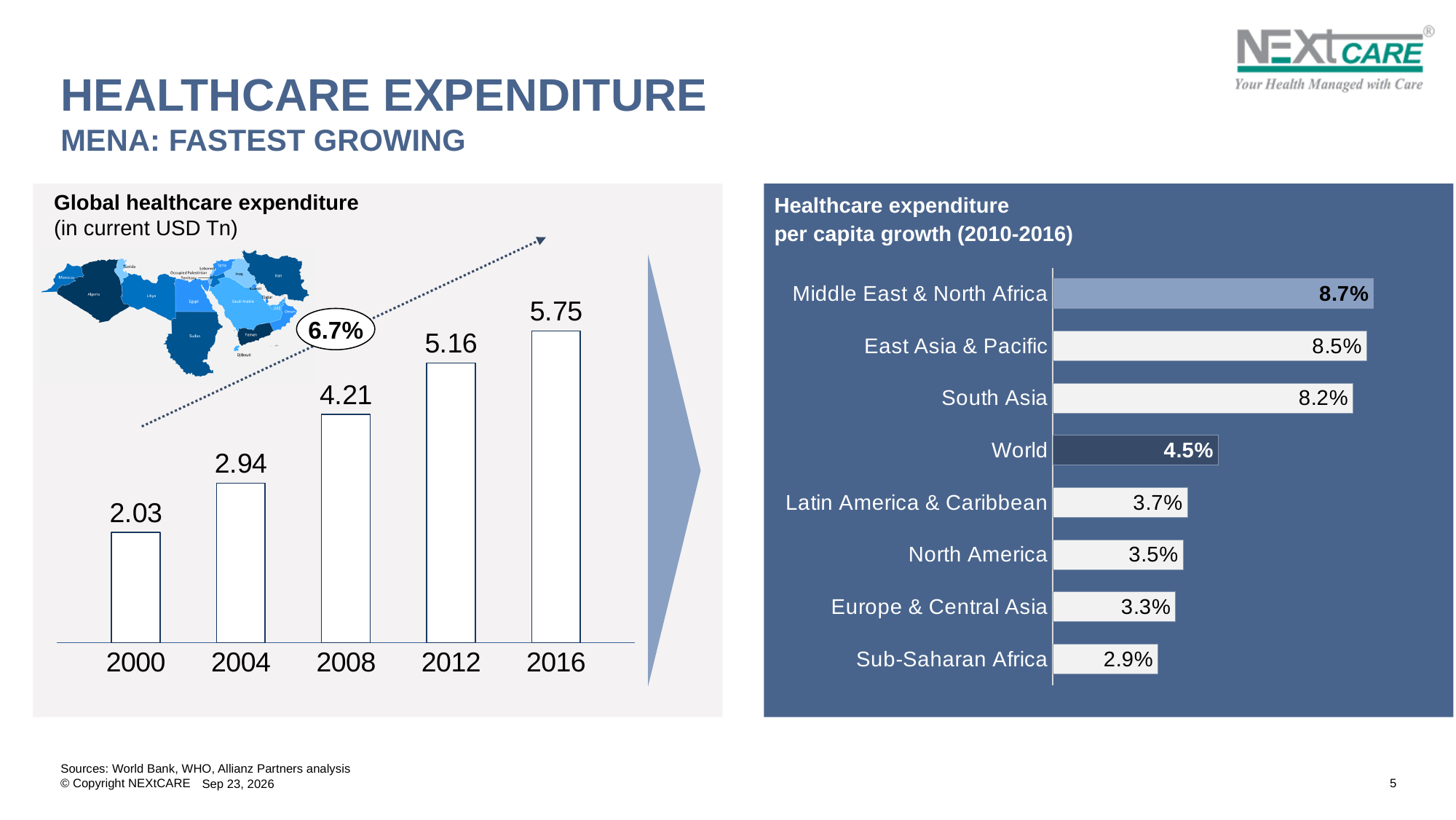
What kind of chart is the 'Global healthcare expenditure' chart? bar chart In the 'Global healthcare expenditure' chart, how many years are plotted? 5 In the 'Healthcare expenditure per capita growth (2010-2016)' chart, what is the difference between Middle East & North Africa and World? 4.2% In the 'Global healthcare expenditure' chart, what is the value for 2016? 5.75 In the 'Global healthcare expenditure' chart, what is the value for 2008? 4.21 In the 'Healthcare expenditure per capita growth (2010-2016)' chart, which is larger: North America or Europe & Central Asia? North America In the 'Healthcare expenditure per capita growth (2010-2016)' chart, what is the value for South Asia? 8.2% In the 'Healthcare expenditure per capita growth (2010-2016)' chart, which region has the lowest value? Sub-Saharan Africa In the 'Global healthcare expenditure' chart, do the values rise or fall from 2000 to 2016? rise In the 'Healthcare expenditure per capita growth (2010-2016)' chart, how many regions are listed? 8 In the 'Healthcare expenditure per capita growth (2010-2016)' chart, which region has the highest value? Middle East & North Africa In the 'Global healthcare expenditure' chart, what is the difference between the 2016 and 2000 values? 3.72